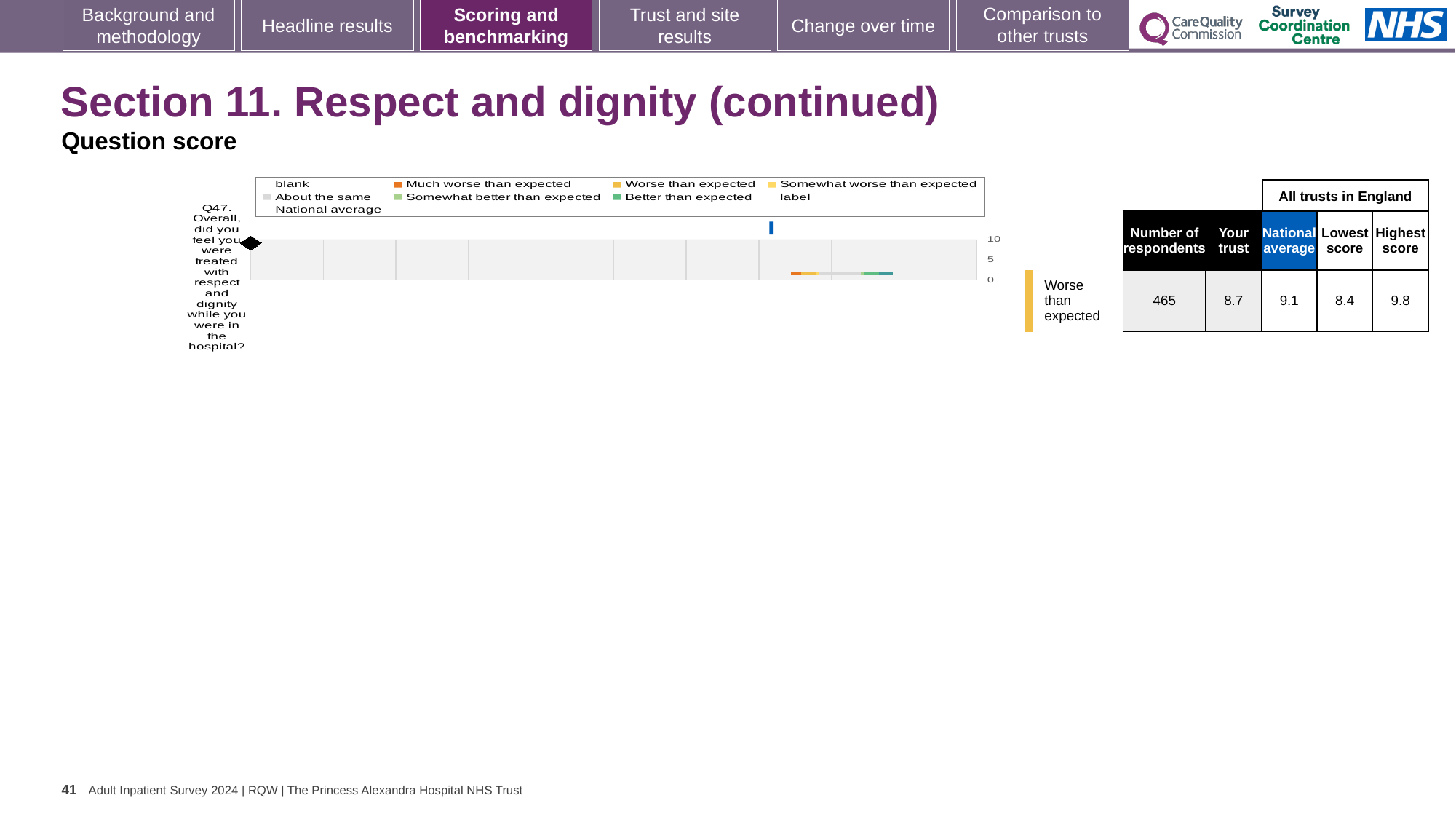
Is the 'Your trust' score for Q47 greater or less than 5? greater Which is larger for Q47, the 'Your trust' score or the national average? National average What kind of chart is shown on the slide? bar chart How many questions (categories) are plotted on the chart? 1 What is the difference between the highest score (9.8) and the lowest score (8.4) in the table beside the chart? 1.4 According to the table beside the chart, what is the national average score for Q47? 9.1 According to the table beside the chart, what is the number of respondents for Q47? 465 According to the table beside the chart, what is the 'Your trust' score for Q47? 8.7 What is the highest tick value shown on the chart's axis? 10 Which question number is plotted on the chart? Q47 What benchmark rating is shown next to the chart for Q47? Worse than expected